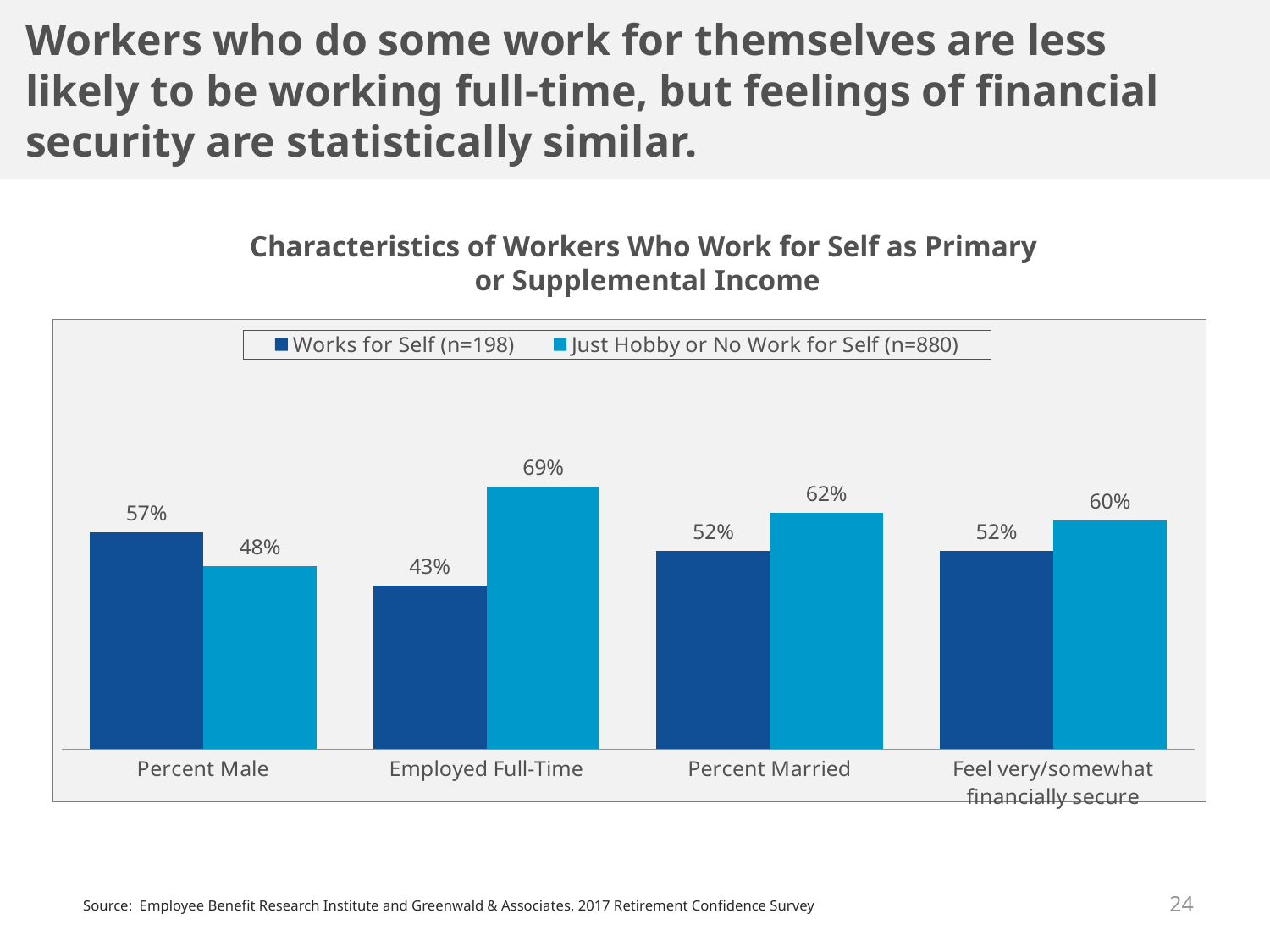
What is the value for Employed Full-Time in the Just Hobby or No Work for Self (n=880) series? 69% How many categories are shown on the x axis? 4 Which category has the lowest value for the Works for Self (n=198) series? Employed Full-Time What percentage of the Works for Self (n=198) group is male? 57% How many series does the legend list? 2 What is the difference between the two series for Employed Full-Time? 26 percentage points What percentage of the Works for Self (n=198) group feel very/somewhat financially secure? 52% Which category has the highest value for the Just Hobby or No Work for Self (n=880) series? Employed Full-Time What is the title of the chart? Characteristics of Workers Who Work for Self as Primary or Supplemental Income What is the difference between the two series for Percent Male? 9 percentage points What kind of chart is shown on the slide? Bar chart For Percent Married, which series has the larger value? Just Hobby or No Work for Self (n=880)